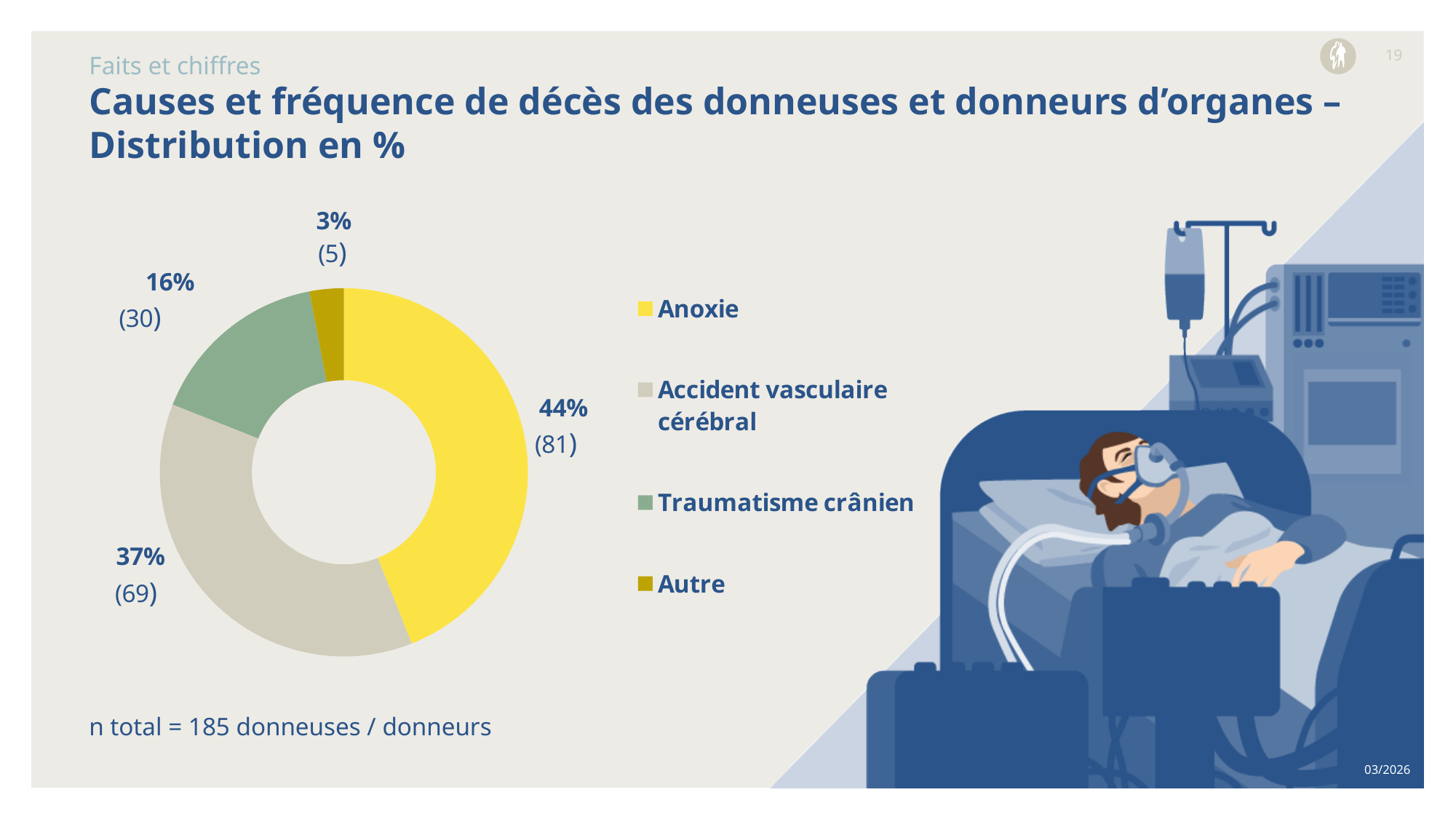
Which has a larger share: Traumatisme crânien or Accident vasculaire cérébral? Accident vasculaire cérébral How many categories does the pie chart show? 4 How many more donors are in the Traumatisme crânien category than in the Autre category? 25 How many donors fall under the Autre category? 5 What percentage share does Traumatisme crânien have? 16% Which cause of death has the largest share of the pie? Anoxie What kind of chart is shown on the slide? Doughnut chart How many donors are in the Accident vasculaire cérébral category? 69 Which cause of death has the smallest share of the pie? Autre What percentage of organ donor deaths is attributed to Anoxie? 44% What is the difference in percentage points between Anoxie and Accident vasculaire cérébral? 7 What is the total number of donors stated below the chart? 185